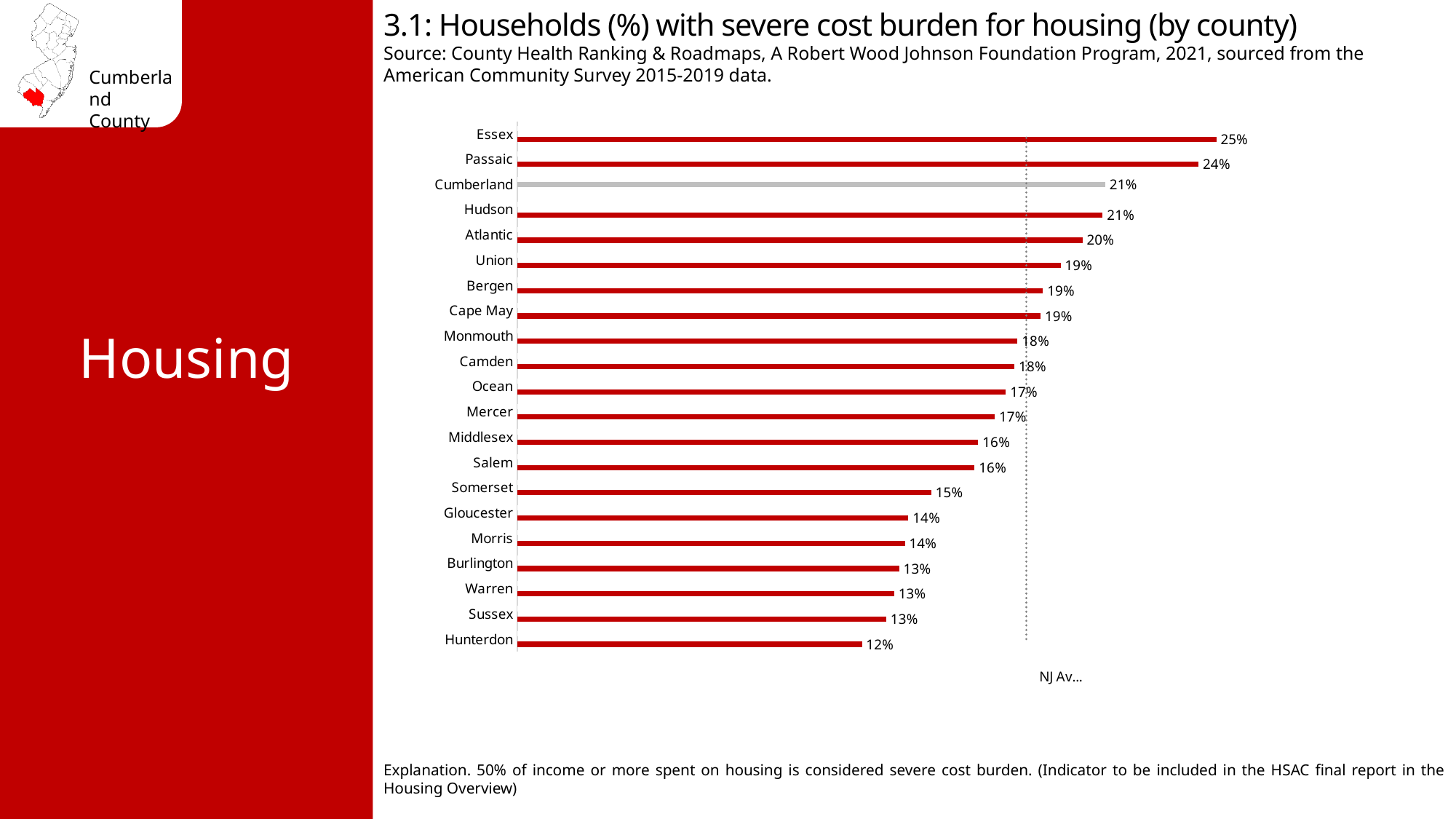
How many counties are shown in the chart? 21 What is the value for Cumberland? 21% Which county has the lowest percentage of households with severe cost burden? Hunterdon What is the value for Hunterdon? 12% Which is larger, the value for Atlantic or the value for Middlesex? Atlantic What kind of chart is this? Bar chart What is the difference between the values for Passaic and Cumberland? 3% Which county's bar is shown in grey rather than red? Cumberland What is the value for Essex? 25% What is the value for Somerset? 15% What is the difference between the values for Essex and Hunterdon? 13% Which county has the highest percentage of households with severe cost burden? Essex